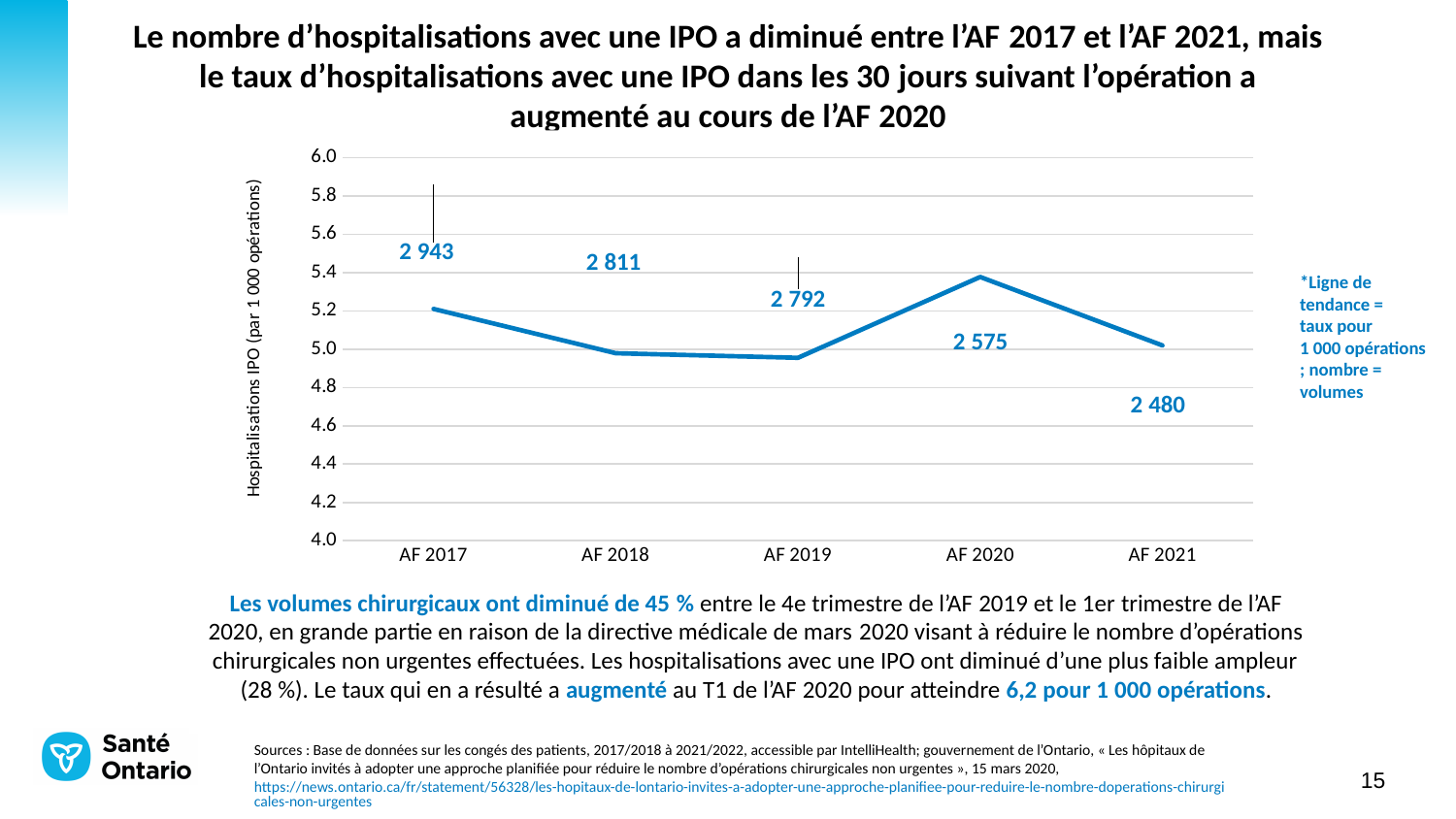
How many fiscal years are plotted on the x axis? 5 Is the rate (per 1 000 opérations) for AF 2020 greater or less than 5.2? greater What volume label is shown for AF 2021? 2 480 What is the difference between the labelled volumes for AF 2017 and AF 2021? 463 What kind of chart is shown on the slide? Line chart Which has the larger labelled volume, AF 2018 or AF 2019? AF 2018 What volume label is shown for AF 2017? 2 943 Which fiscal year has the highest labelled volume of hospitalisations with an IPO? AF 2017 Which fiscal year has the lowest labelled volume of hospitalisations with an IPO? AF 2021 What volume label is shown for AF 2020? 2 575 In which fiscal year does the trend line reach its highest rate? AF 2020 Is the rate (per 1 000 opérations) for AF 2021 greater or less than 5.4? less